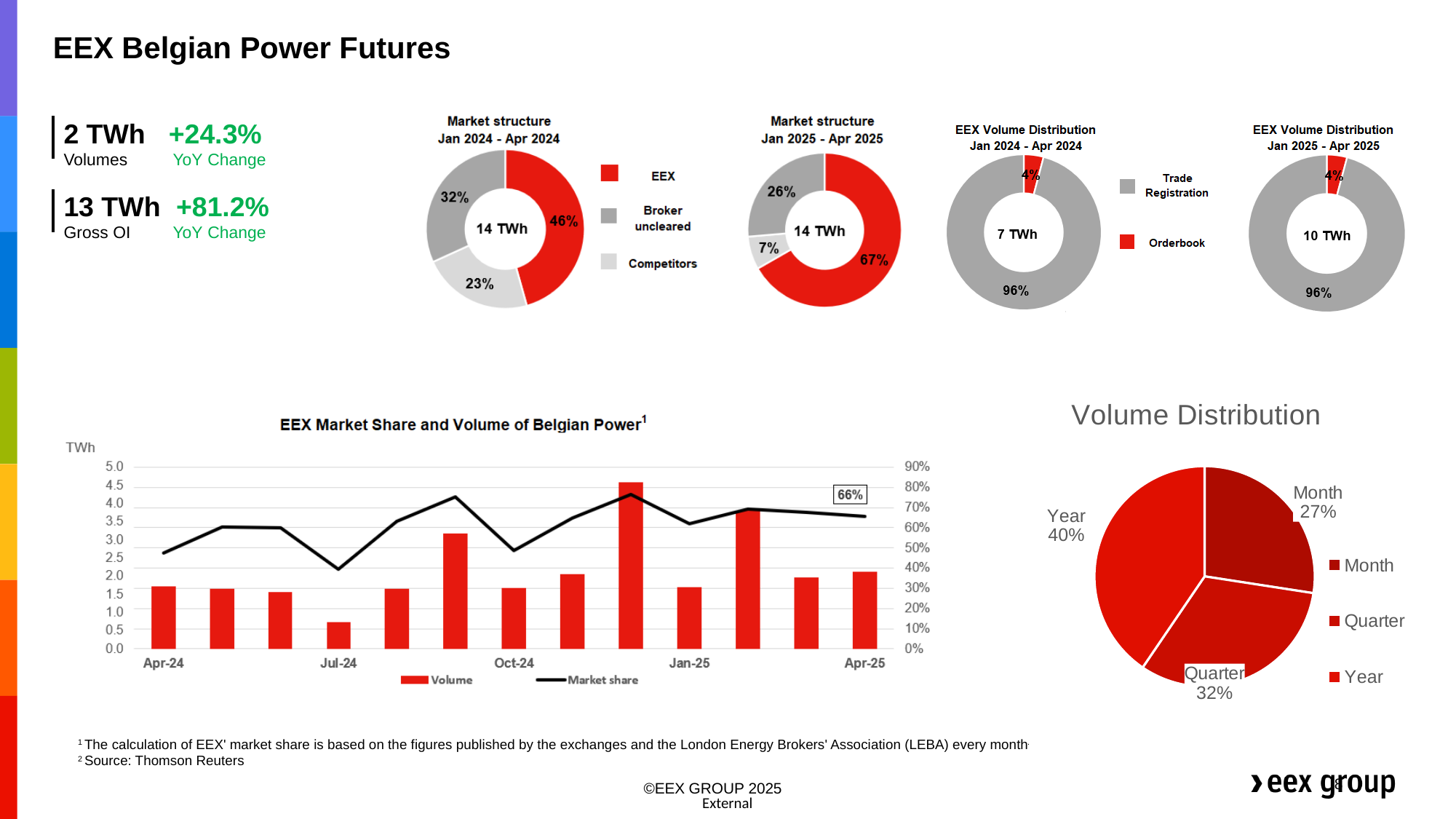
In the 'EEX Market Share and Volume of Belgian Power' chart, what market share value is labelled at the end of the line? 66% In the 'EEX Volume Distribution Jan 2024 - Apr 2024' donut chart, what share does Orderbook have? 4% In the 'EEX Market Share and Volume of Belgian Power' chart, is the volume bar for Jul-24 greater or less than 1.0 TWh? less Comparing the two 'Market structure' donut charts, by how many percentage points did the EEX share change from Jan-Apr 2024 to Jan-Apr 2025? 21 percentage points In the 'Volume Distribution' pie chart, what is the share for Quarter? 32% In the 'Market structure Jan 2025 - Apr 2025' donut chart, what share do Competitors hold? 7% In the 'Volume Distribution' pie chart, which category has the largest share? Year In the 'Volume Distribution' pie chart, what is the difference between the Year share and the Month share? 13 percentage points In the 'EEX Volume Distribution Jan 2025 - Apr 2025' donut chart, what total volume is shown in the centre? 10 TWh In the 'Market structure Jan 2025 - Apr 2025' donut chart, which segment is the largest? EEX In the 'Market structure Jan 2024 - Apr 2024' donut chart, what share does EEX hold? 46% How many series does the legend of the 'EEX Market Share and Volume of Belgian Power' chart list? 2